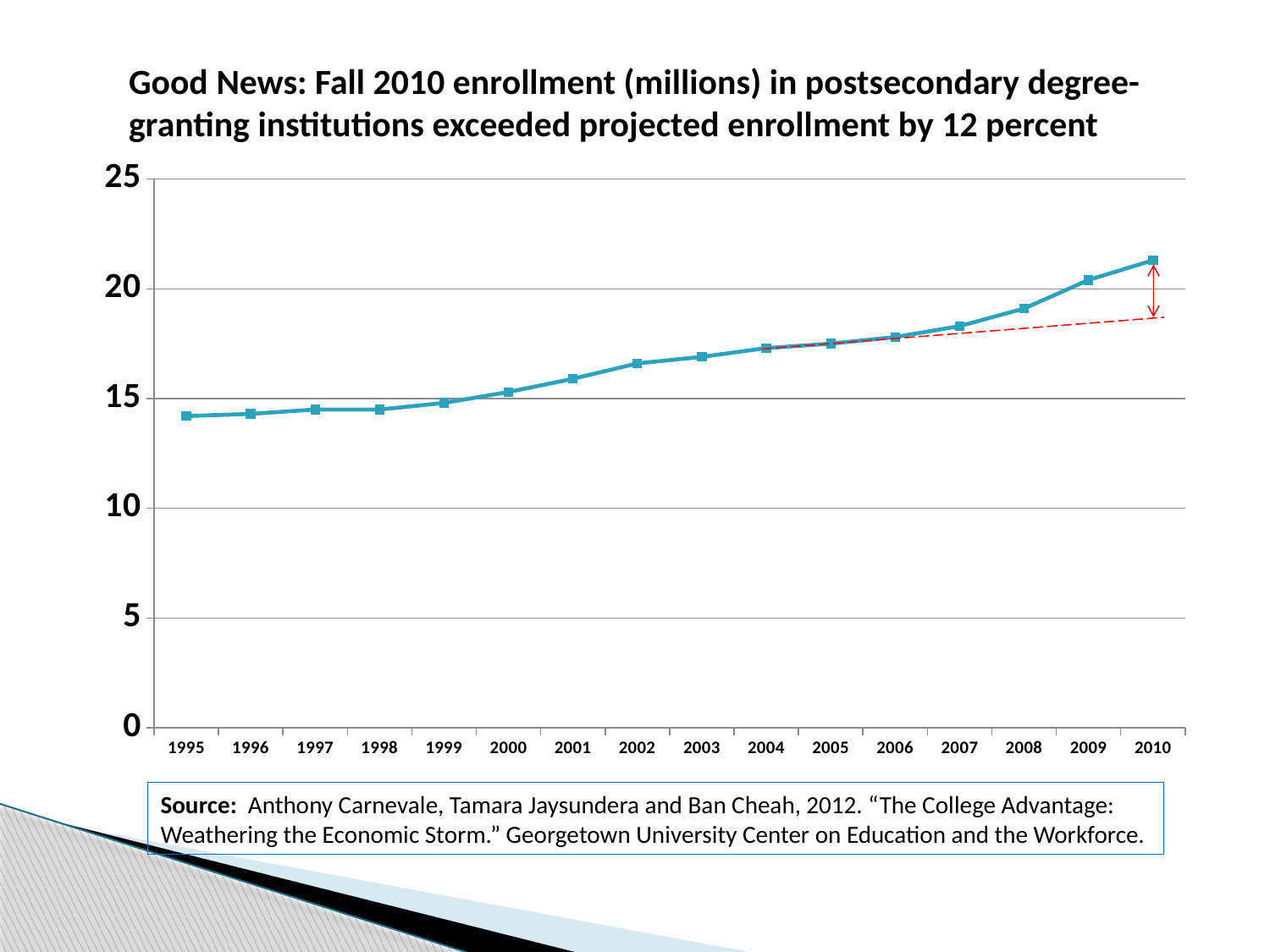
Is the enrollment value for 2002 greater or less than 15? greater By what percent did Fall 2010 enrollment exceed projected enrollment, according to the chart title? 12 percent Do enrollment values generally rise or fall from 1995 to 2010? rise Is the enrollment value for 1995 greater or less than 15? less Which year has the larger enrollment value, 2003 or 2008? 2008 Is the enrollment value for 1998 greater or less than 15? less Which year has the highest enrollment value? 2010 How many years are plotted along the x axis? 16 Which year has the larger enrollment value, 2010 or 1995? 2010 What kind of chart is shown on the slide? line chart